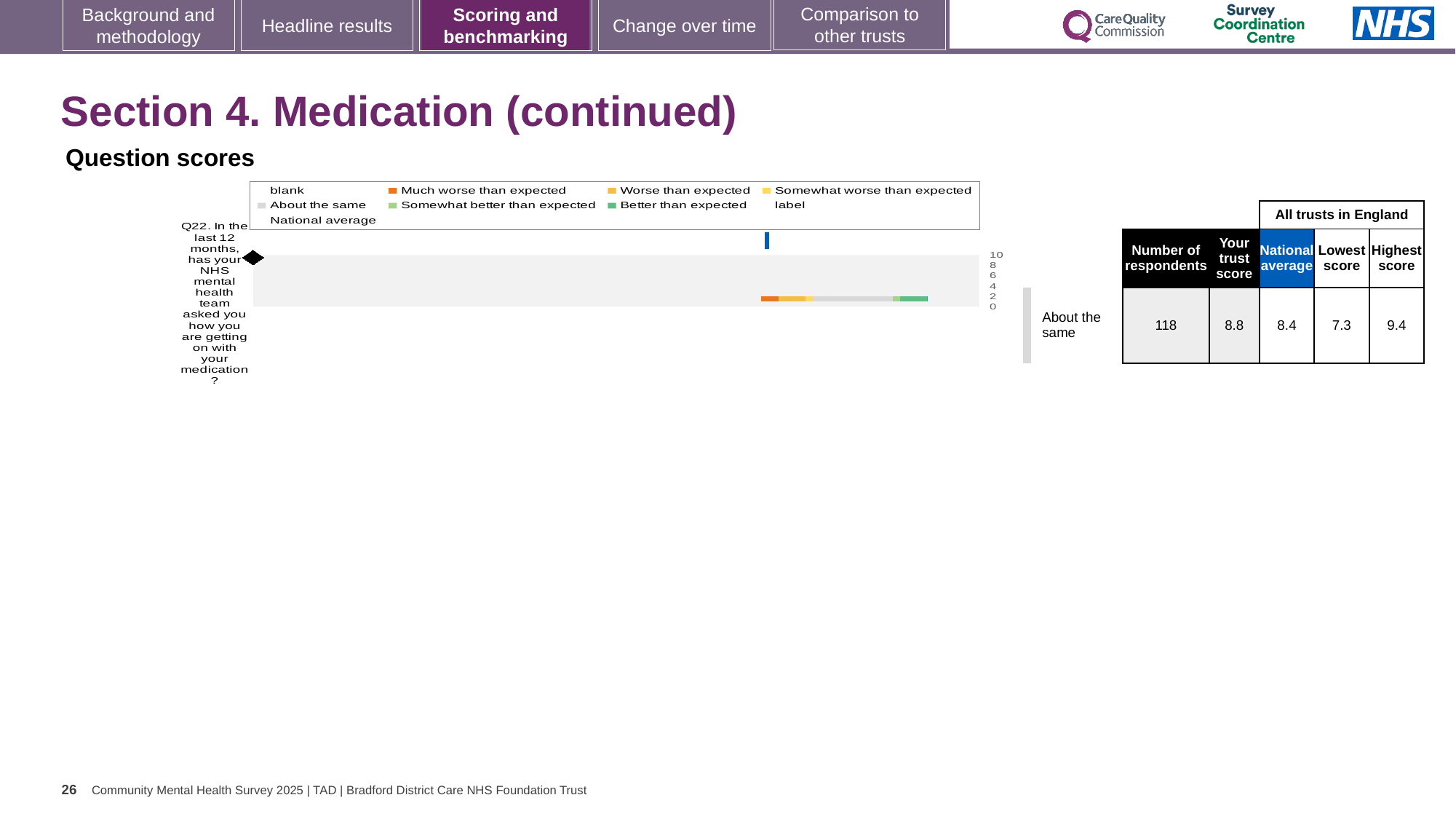
What benchmark category is shown beside the chart for Q22? About the same In the table next to the chart, what is the number of respondents for Q22? 118 In the table next to the chart, what is the lowest score among all trusts in England for Q22? 7.3 In the table next to the chart, what is the highest score among all trusts in England for Q22? 9.4 How many questions (categories) are plotted on the chart? 1 What is the difference between the highest score and the lowest score for Q22 in the table? 2.1 Which question number is plotted on the chart? Q22 In the table next to the chart, what is 'Your trust score' for Q22? 8.8 What kind of chart is shown under 'Question scores'? bar chart Which is larger for Q22, the trust score or the national average? trust score In the table next to the chart, what is the national average for Q22? 8.4 What is the highest value shown on the chart's numeric axis? 10